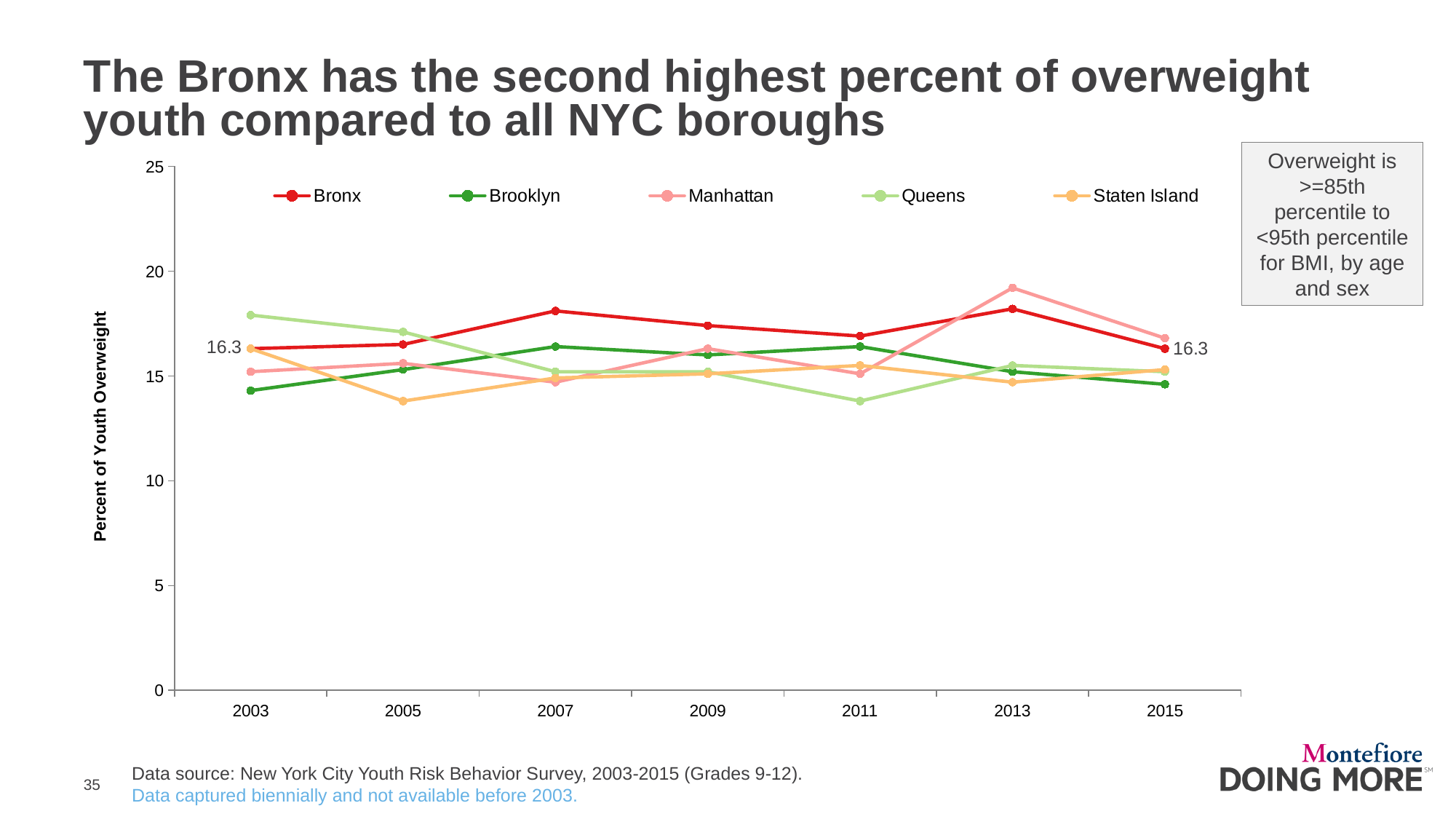
Is the value for Queens in 2011 greater or less than 15? less In 2009, which is larger, the value for Bronx or the value for Brooklyn? Bronx How many series does the legend list? 5 What kind of chart is shown on the slide? line chart How many years are shown on the x axis? 7 What is the value for Bronx in 2003? 16.3 Is the value for Manhattan in 2013 greater or less than 15? greater What is the value for Bronx in 2015? 16.3 What is the title of the y axis? Percent of Youth Overweight What is the difference between the Bronx value in 2015 and the Bronx value in 2003? 0 Which borough has the lowest value in 2011? Queens Which borough has the highest value in 2013? Manhattan